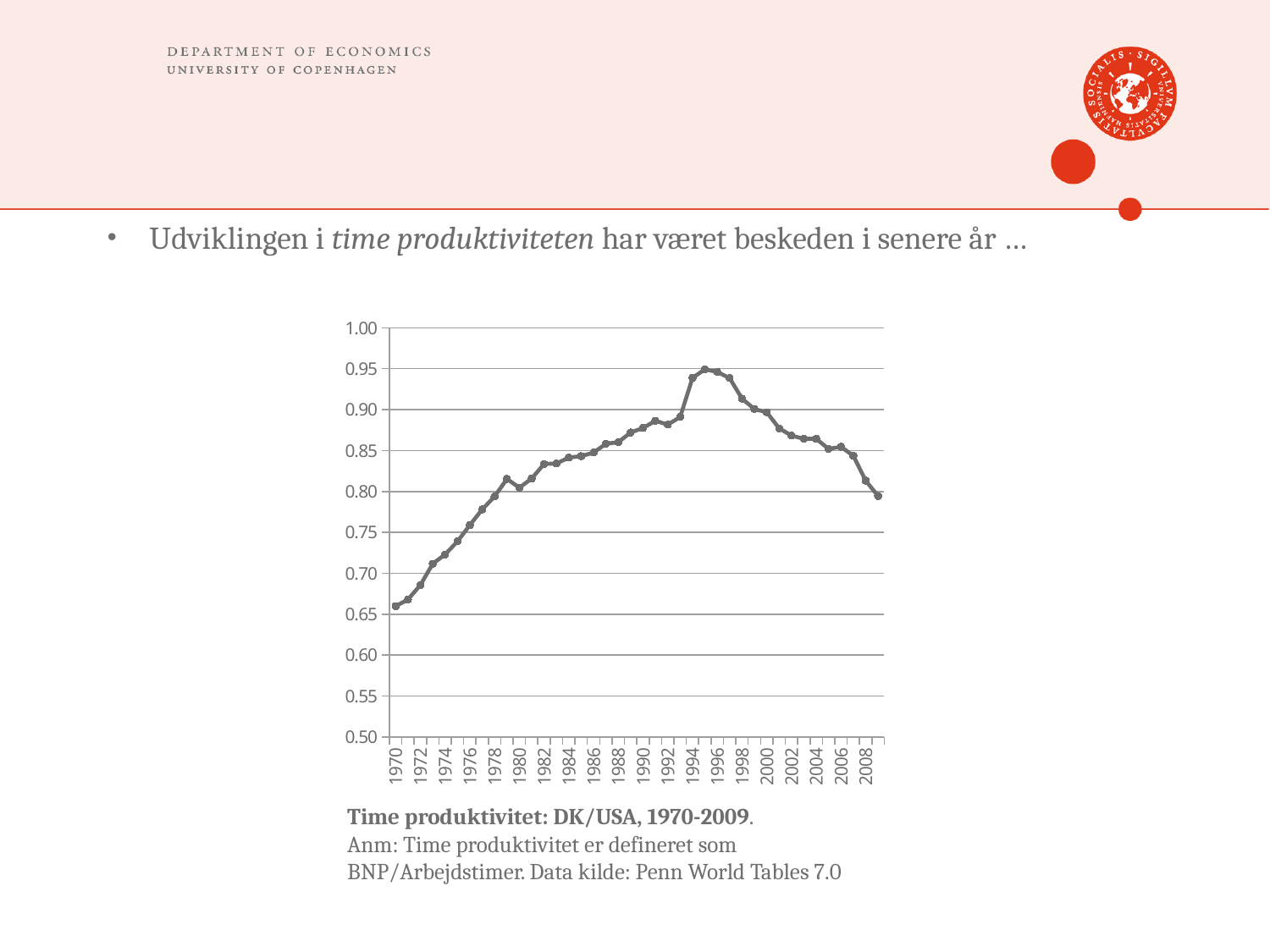
Is the value for 1995 greater or less than 0.90? greater Is the value for 2005 greater or less than 0.90? less What is the title of the chart, as given in the caption below it? Time produktivitet: DK/USA, 1970-2009 What data source is cited for the chart? Penn World Tables 7.0 Which year has the larger value, 1970 or 2009? 2009 In which year is the plotted value lowest? 1970 What kind of chart is shown on the slide? line chart Is the value for 1975 greater or less than 0.70? greater Does the line generally rise or fall between 1970 and 1995? rise Which year has the larger value, 1995 or 2005? 1995